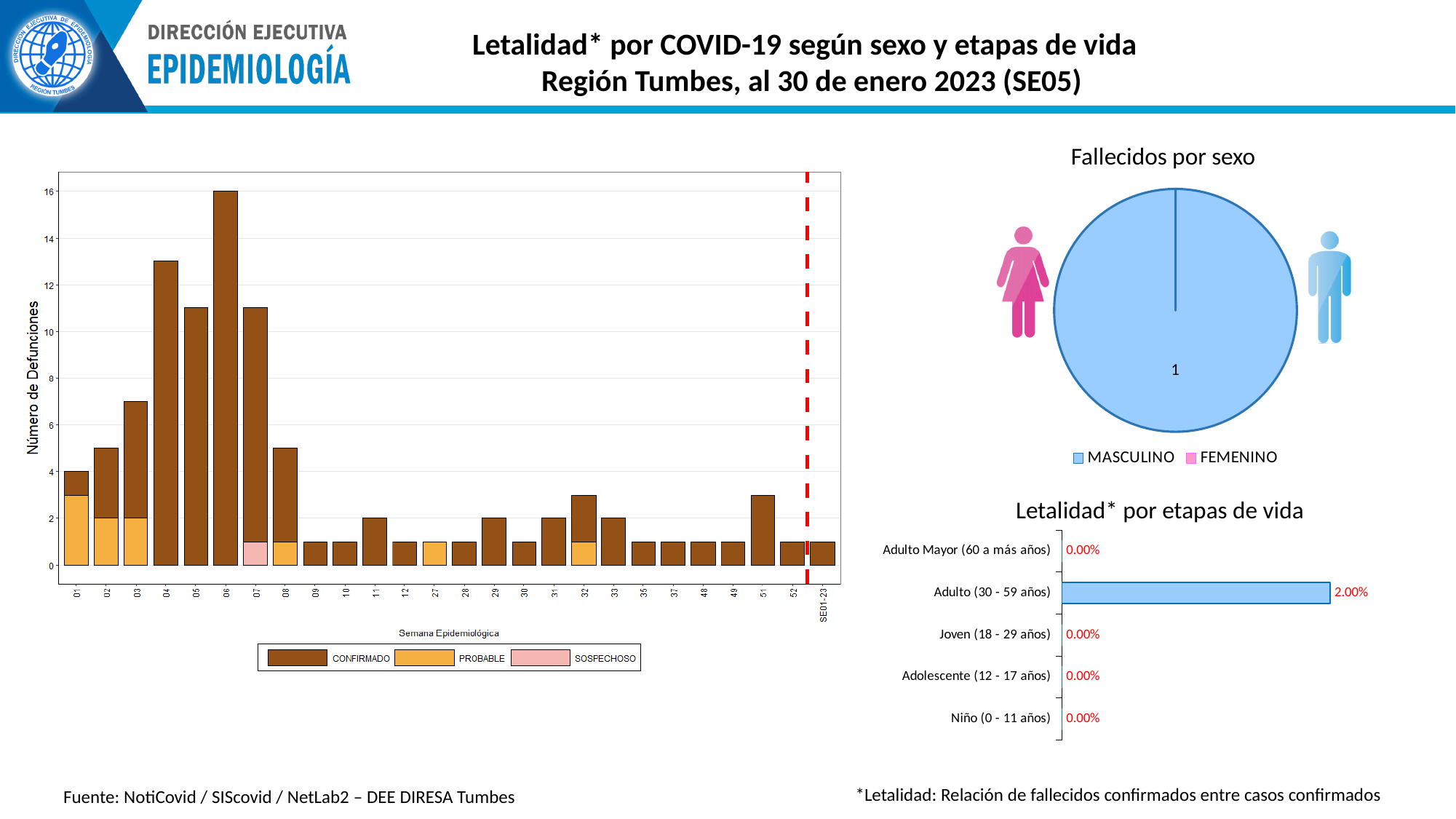
In the 'Letalidad* por etapas de vida' chart, what is the difference between the values for Adulto (30 - 59 años) and Joven (18 - 29 años)? 2.00% In the bar chart on the left (Número de Defunciones by Semana Epidemiológica), what is the total number of deaths in week 06? 16 In the 'Letalidad* por etapas de vida' chart, which age group has the highest value? Adulto (30 - 59 años) How many series does the legend of the 'Fallecidos por sexo' chart list? 2 In the 'Letalidad* por etapas de vida' chart, what is the value for Adulto (30 - 59 años)? 2.00% In the 'Letalidad* por etapas de vida' chart, what is the value for Adulto Mayor (60 a más años)? 0.00% In the 'Fallecidos por sexo' chart, what value is shown for MASCULINO? 1 In the bar chart on the left (Número de Defunciones by Semana Epidemiológica), is the total for week 04 greater or less than 12? greater How many series does the legend of the bar chart on the left (Número de Defunciones) list? 3 In the bar chart on the left (Número de Defunciones by Semana Epidemiológica), which week has the highest total number of deaths? 06 What kind of chart is 'Fallecidos por sexo'? Pie chart How many age groups are shown in the 'Letalidad* por etapas de vida' chart? 5